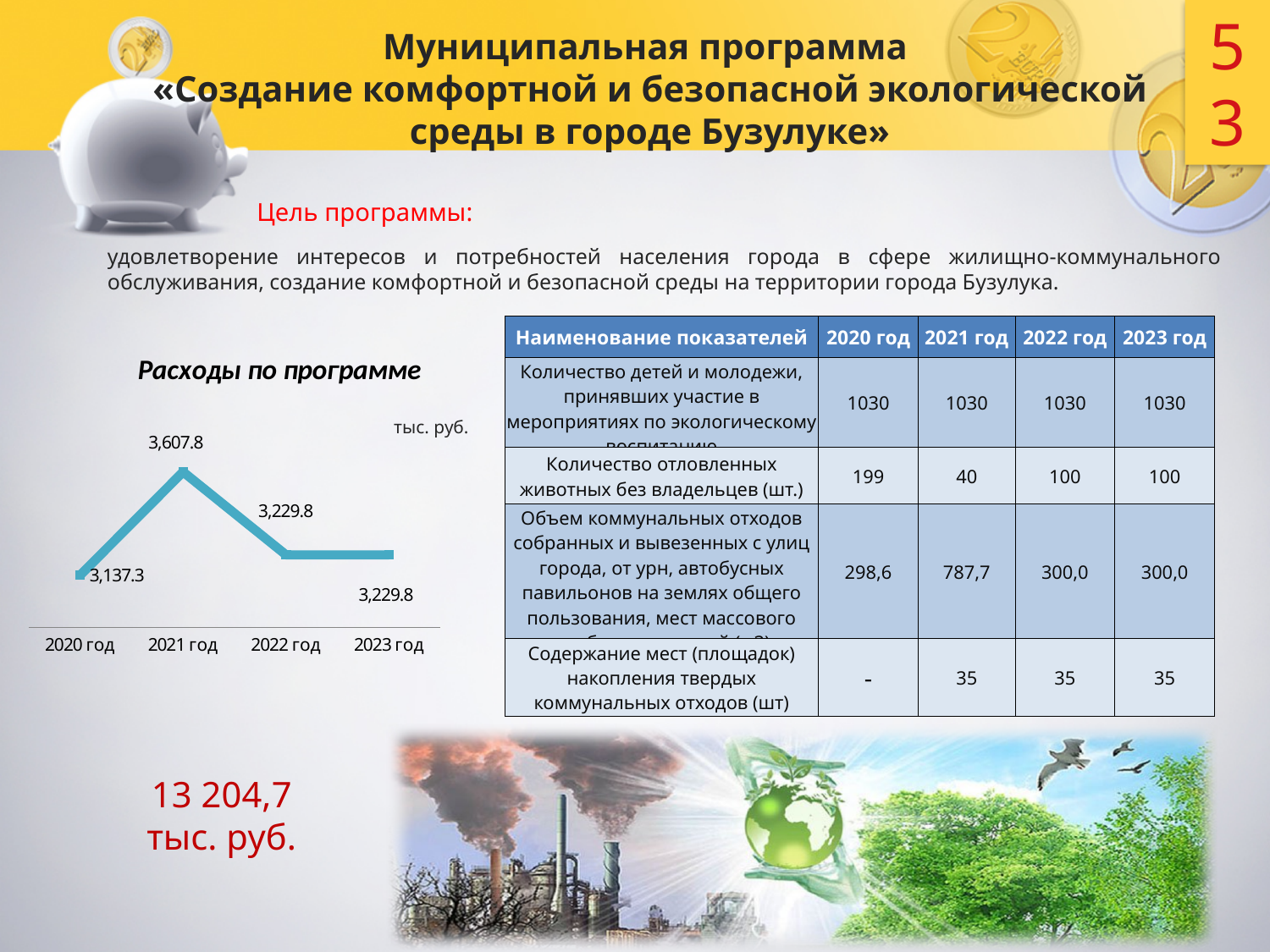
Which year has the highest value in the 'Расходы по программе' chart? 2021 год What is the value for 2021 год in the 'Расходы по программе' chart? 3,607.8 How many years are plotted in the 'Расходы по программе' chart? 4 What is the value for 2023 год in the 'Расходы по программе' chart? 3,229.8 In the 'Расходы по программе' chart, which is larger: the value for 2022 год or the value for 2020 год? 2022 год In the 'Расходы по программе' chart, what is the difference between the values for 2021 год and 2020 год? 470.5 What is the value for 2020 год in the 'Расходы по программе' chart? 3,137.3 In the 'Расходы по программе' chart, does the value rise or fall from 2021 год to 2022 год? fall In the 'Расходы по программе' chart, what is the difference between the values for 2021 год and 2022 год? 378.0 What is the value for 2022 год in the 'Расходы по программе' chart? 3,229.8 What type of chart is used for 'Расходы по программе'? line chart Which year has the lowest value in the 'Расходы по программе' chart? 2020 год